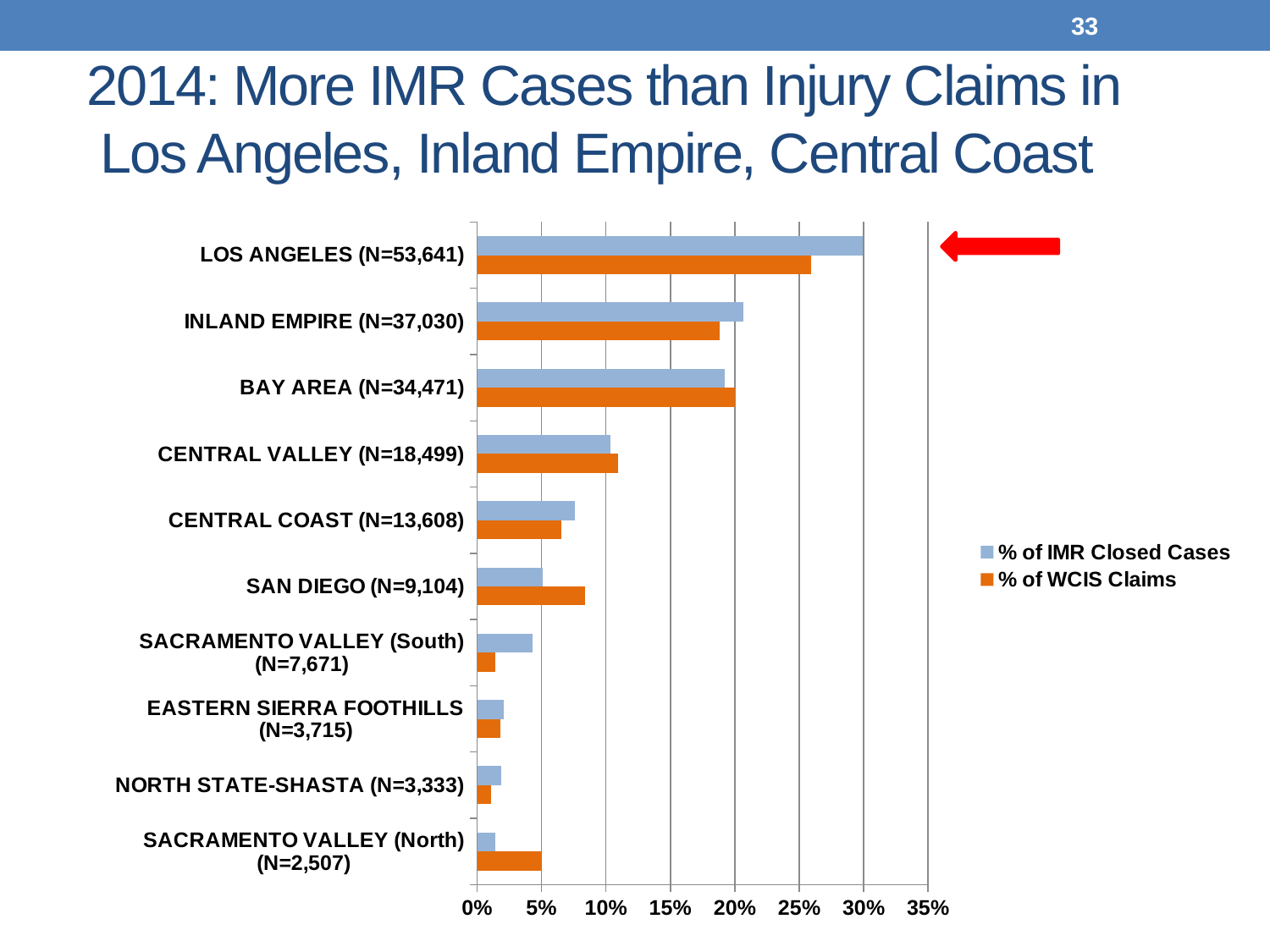
Is the % of WCIS Claims for LOS ANGELES greater or less than 20%? greater For SAN DIEGO, which is larger: % of IMR Closed Cases or % of WCIS Claims? % of WCIS Claims How many series does the legend list? 2 Is the % of WCIS Claims for SAN DIEGO greater or less than 5%? greater How many regions are listed on the chart? 10 Which region has the highest % of WCIS Claims? LOS ANGELES (N=53,641) What kind of chart is shown on the slide? bar chart Is the % of IMR Closed Cases for LOS ANGELES greater or less than 25%? greater For SACRAMENTO VALLEY (North), which is larger: % of IMR Closed Cases or % of WCIS Claims? % of WCIS Claims Which region has the highest % of IMR Closed Cases? LOS ANGELES (N=53,641) Which series is shown in orange in the legend? % of WCIS Claims